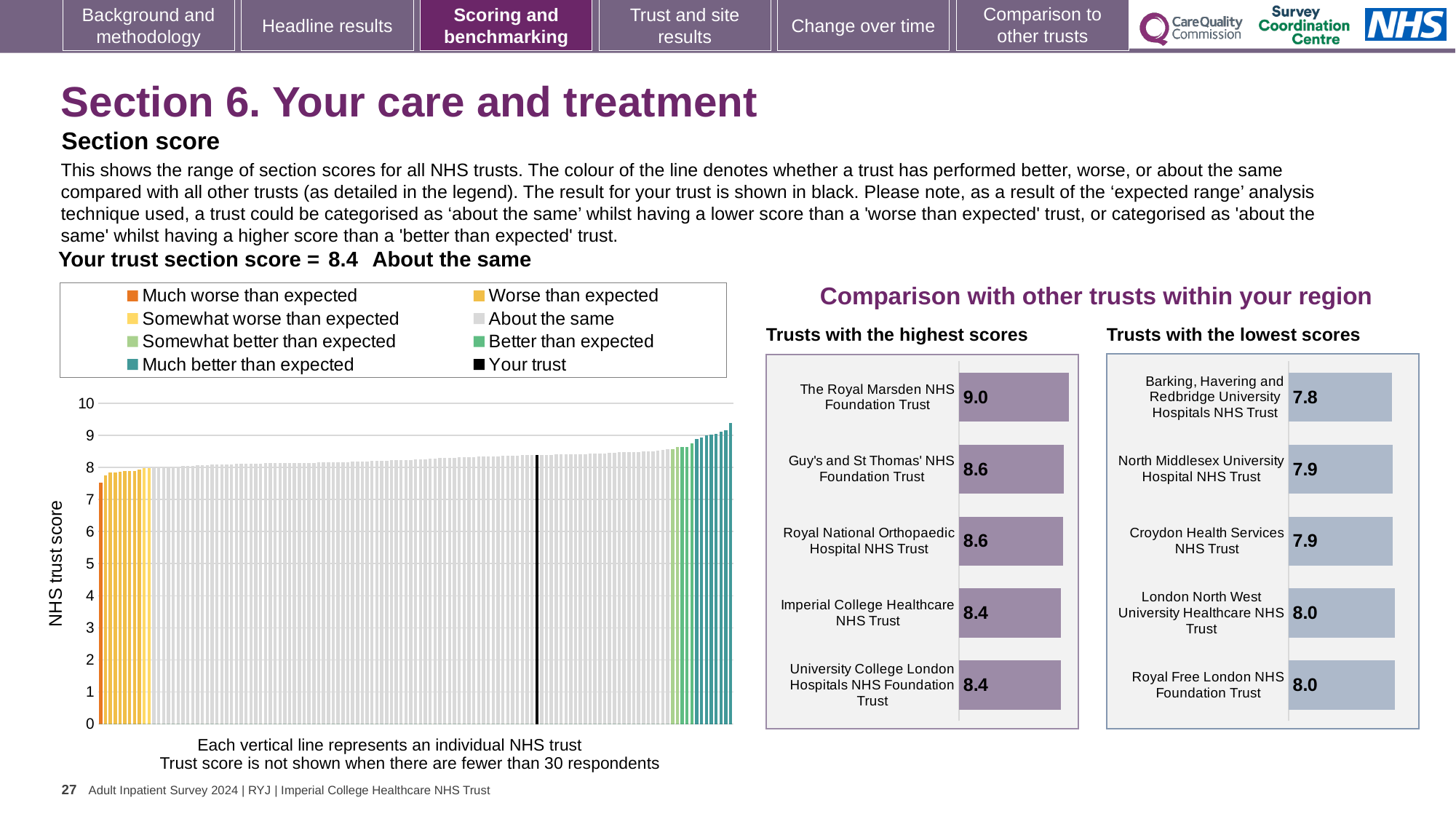
In the 'Trusts with the highest scores' chart, which trust has the highest score? The Royal Marsden NHS Foundation Trust What kind of chart is the main 'NHS trust score' chart? bar chart In the 'Trusts with the lowest scores' chart, which trust has the lowest score? Barking, Havering and Redbridge University Hospitals NHS Trust In the main 'NHS trust score' chart, is the value of the leftmost (lowest) bar greater or less than 8? less How many trusts are shown in the 'Trusts with the highest scores' chart? 5 In the 'Trusts with the highest scores' chart, what is the difference between the scores of The Royal Marsden NHS Foundation Trust and Imperial College Healthcare NHS Trust? 0.6 In the main 'NHS trust score' chart, do the bar values rise or fall from left to right? rise In the 'Trusts with the lowest scores' chart, which has the larger score: Royal Free London NHS Foundation Trust or Barking, Havering and Redbridge University Hospitals NHS Trust? Royal Free London NHS Foundation Trust In the 'Trusts with the highest scores' chart, what is the score for The Royal Marsden NHS Foundation Trust? 9.0 In the main 'NHS trust score' chart, what is the section score for your trust (the black line)? 8.4 How many entries does the legend of the main 'NHS trust score' chart list? 8 In the 'Trusts with the lowest scores' chart, what is the score for Croydon Health Services NHS Trust? 7.9